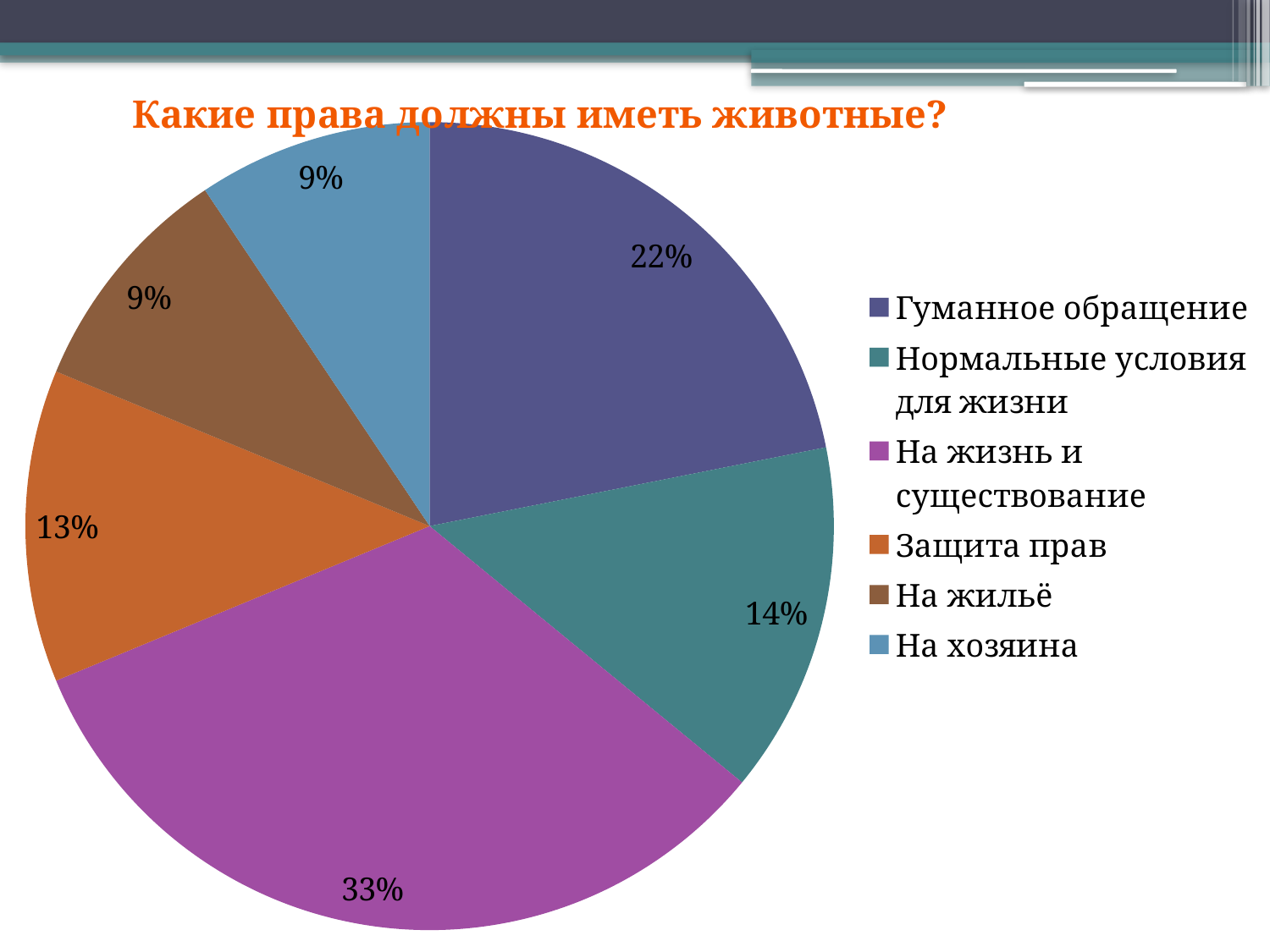
What is the difference in percentage points between 'На жизнь и существование' and 'Гуманное обращение'? 11 Which is larger, 'Гуманное обращение' or 'Нормальные условия для жизни'? Гуманное обращение What share of the pie is 'Нормальные условия для жизни'? 14% How many slices does the pie chart have? 6 What share of the pie is 'Гуманное обращение'? 22% What is the title of the chart? Какие права должны иметь животные? What type of chart is shown on the slide? pie chart How many entries does the legend list? 6 Which category has the largest slice of the pie? На жизнь и существование What share of the pie is 'Защита прав'? 13%